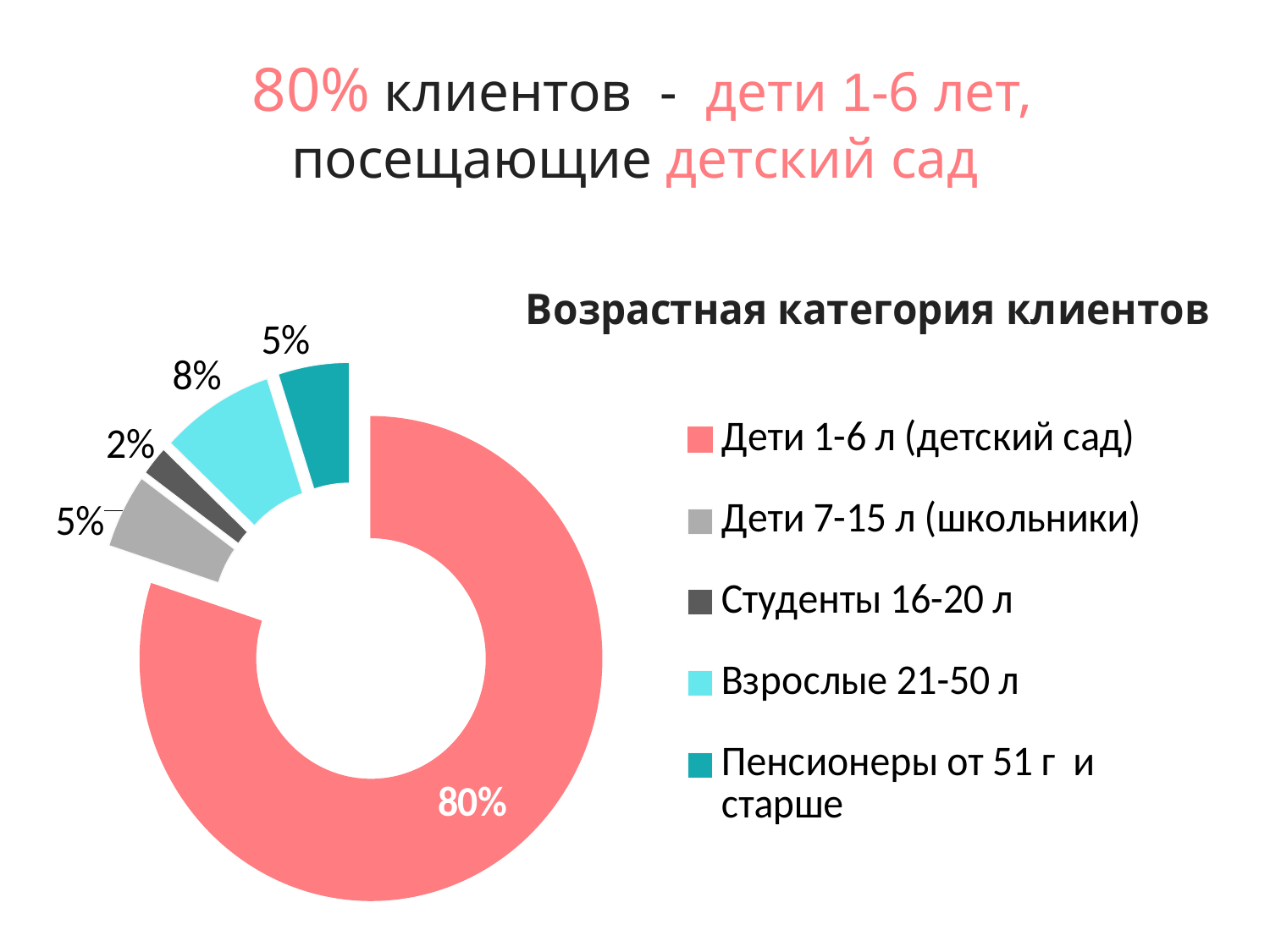
What share of clients are Взрослые 21-50 л? 8% Which category has the largest share of clients? Дети 1-6 л (детский сад) What share of clients are Дети 1-6 л (детский сад)? 80% What share of clients are Студенты 16-20 л? 2% Which is larger: the share of Взрослые 21-50 л or the share of Дети 7-15 л (школьники)? Взрослые 21-50 л What is the title of the chart? Возрастная категория клиентов What is the difference between the shares of Взрослые 21-50 л and Студенты 16-20 л? 6% How many categories does the chart show? 5 What share of clients are Пенсионеры от 51 г и старше? 5% Which category has the smallest share of clients? Студенты 16-20 л What type of chart is shown on the slide? Doughnut (pie) chart What share of clients are Дети 7-15 л (школьники)? 5%